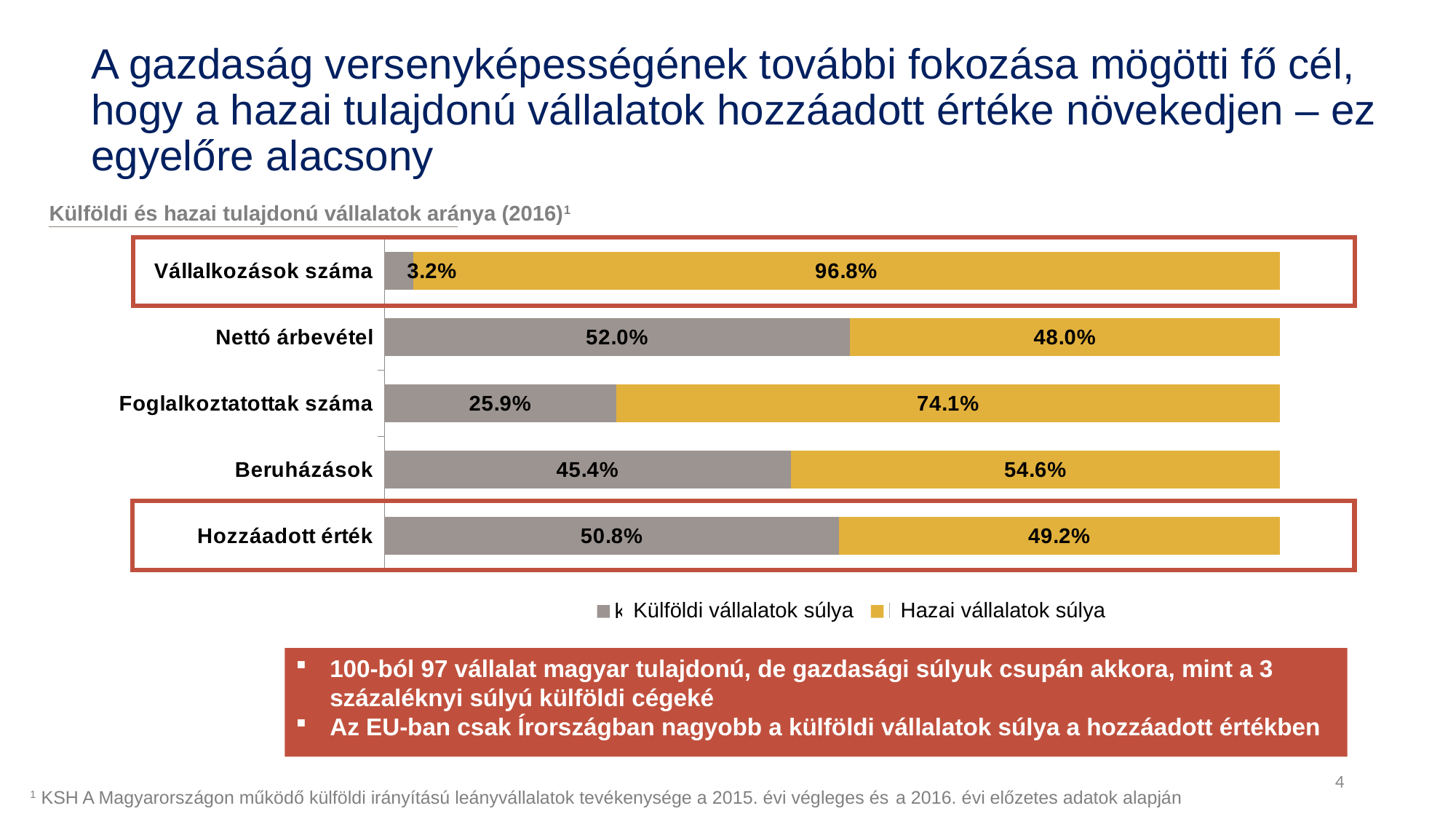
Which is larger for Beruházások: Külföldi vállalatok súlya or Hazai vállalatok súlya? Hazai vállalatok súlya What is the difference between Külföldi vállalatok súlya and Hazai vállalatok súlya for Nettó árbevétel? 4.0 percentage points What is the value of Külföldi vállalatok súlya for Hozzáadott érték? 50.8% How many series does the legend list? 2 What is the title of the chart? Külföldi és hazai tulajdonú vállalatok aránya (2016) Which category has the highest value for Külföldi vállalatok súlya? Nettó árbevétel What is the value of Külföldi vállalatok súlya for Vállalkozások száma? 3.2% Which category has the lowest value for Külföldi vállalatok súlya? Vállalkozások száma What is the value of Hazai vállalatok súlya for Foglalkoztatottak száma? 74.1% How many categories are shown in the chart? 5 What is the value of Hazai vállalatok súlya for Beruházások? 54.6% What kind of chart is shown on the slide? Stacked bar chart